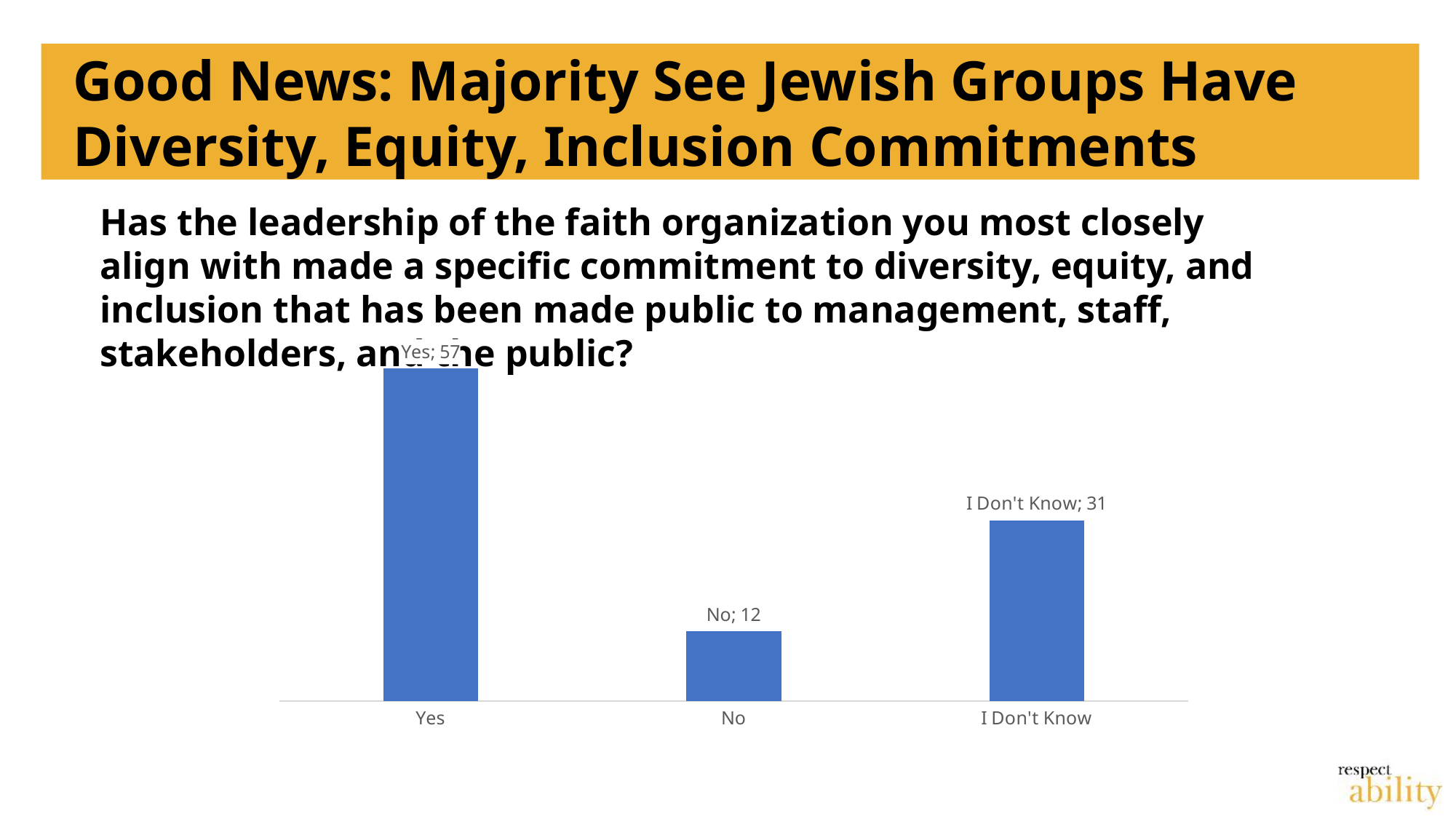
Which is larger, the value for I Don't Know or the value for No? I Don't Know Which category has the lowest value? No What colour are the bars in the chart? Blue What is the value for Yes? 57 Which category has the highest value? Yes What kind of chart is shown on the slide? Bar chart What is the difference between the values for Yes and No? 45 How many categories are shown in the chart? 3 What is the difference between the values for I Don't Know and No? 19 What is the value for I Don't Know? 31 What is the total of the three values shown in the chart? 100 What is the value for No? 12